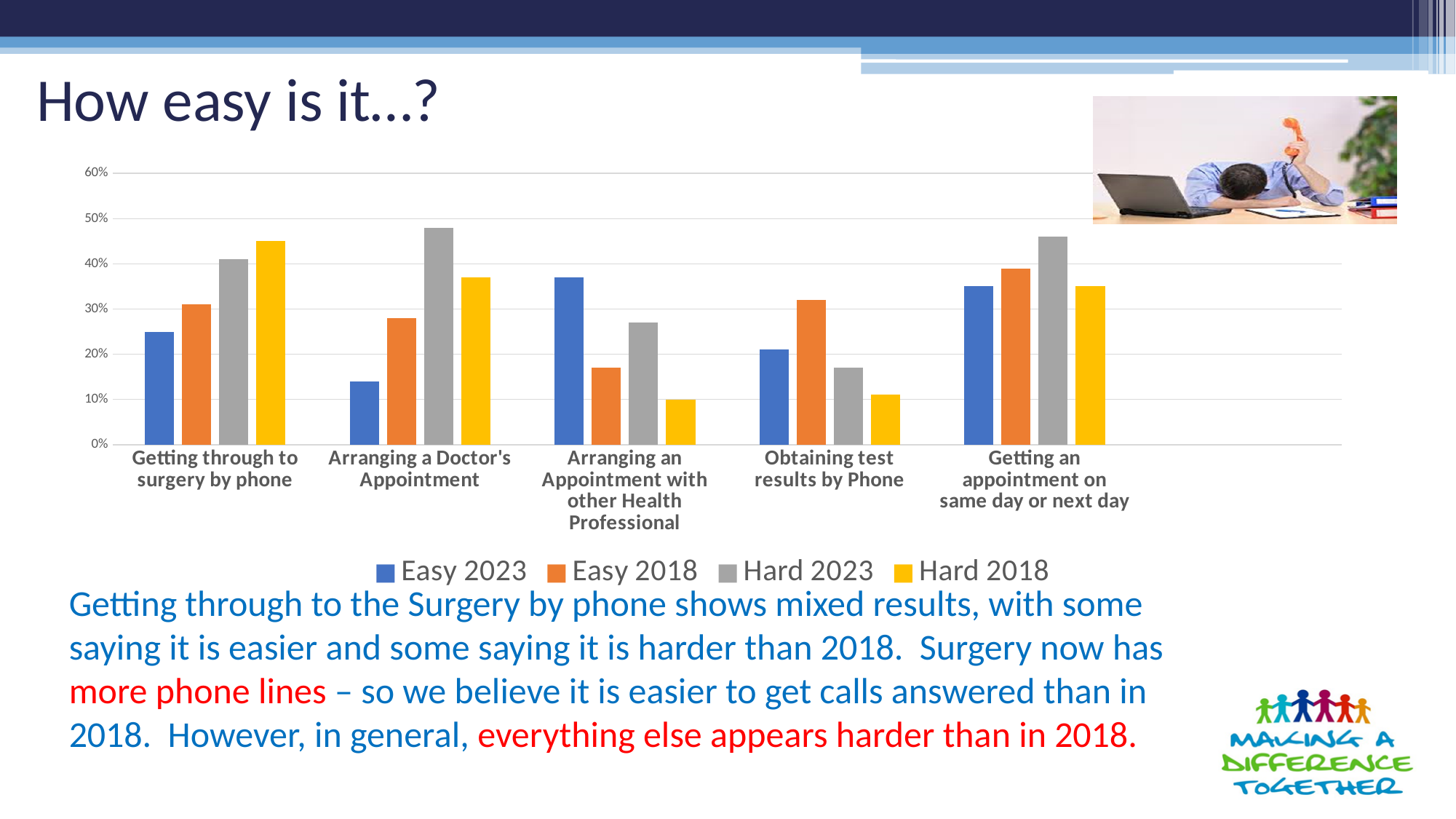
What colour represents the Hard 2018 series in the chart? Yellow Is the Hard 2018 value for Arranging an Appointment with other Health Professional greater or less than 20%? less For Arranging an Appointment with other Health Professional, which series has the highest value? Easy 2023 Is the Easy 2023 value for Arranging a Doctor's Appointment greater or less than 20%? less Is the Hard 2023 value for Arranging a Doctor's Appointment greater or less than 40%? greater For Obtaining test results by Phone, which is larger: Easy 2018 or Hard 2023? Easy 2018 How many categories are shown along the x axis of the chart? 5 How many series does the chart's legend list? 4 For Getting through to surgery by phone, which is larger: Easy 2023 or Easy 2018? Easy 2018 Which category has the lowest Easy 2023 value? Arranging a Doctor's Appointment What kind of chart is shown on the slide? Bar chart What is the highest tick value shown on the chart's y axis? 60%